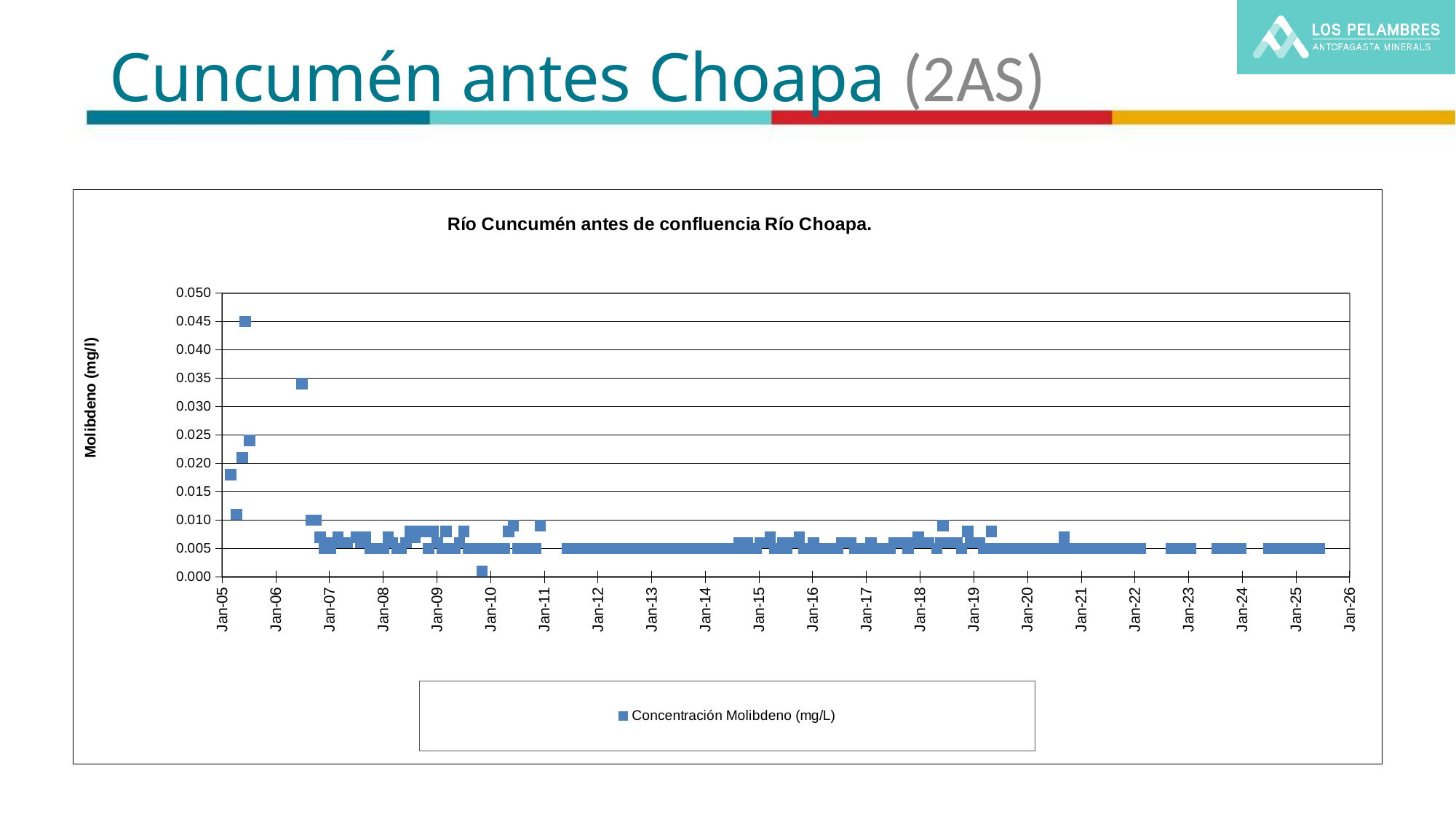
What kind of chart is shown on the slide? scatter chart Do the plotted values generally rise or fall from Jan-05 to Jan-25? fall Is the value plotted in mid-2006 greater or less than 0.030? greater Is the highest plotted value greater or less than 0.040? greater Is the lowest plotted value, near Jan-10, greater or less than 0.005? less What is the legend entry for the plotted series? Concentración Molibdeno (mg/L) How many series does the legend list? 1 What is the highest value shown on the y axis? 0.050 What is the title of the chart? Río Cuncumén antes de confluencia Río Choapa. How many year labels are shown on the x axis? 22 In which year does the highest plotted value occur? 2005